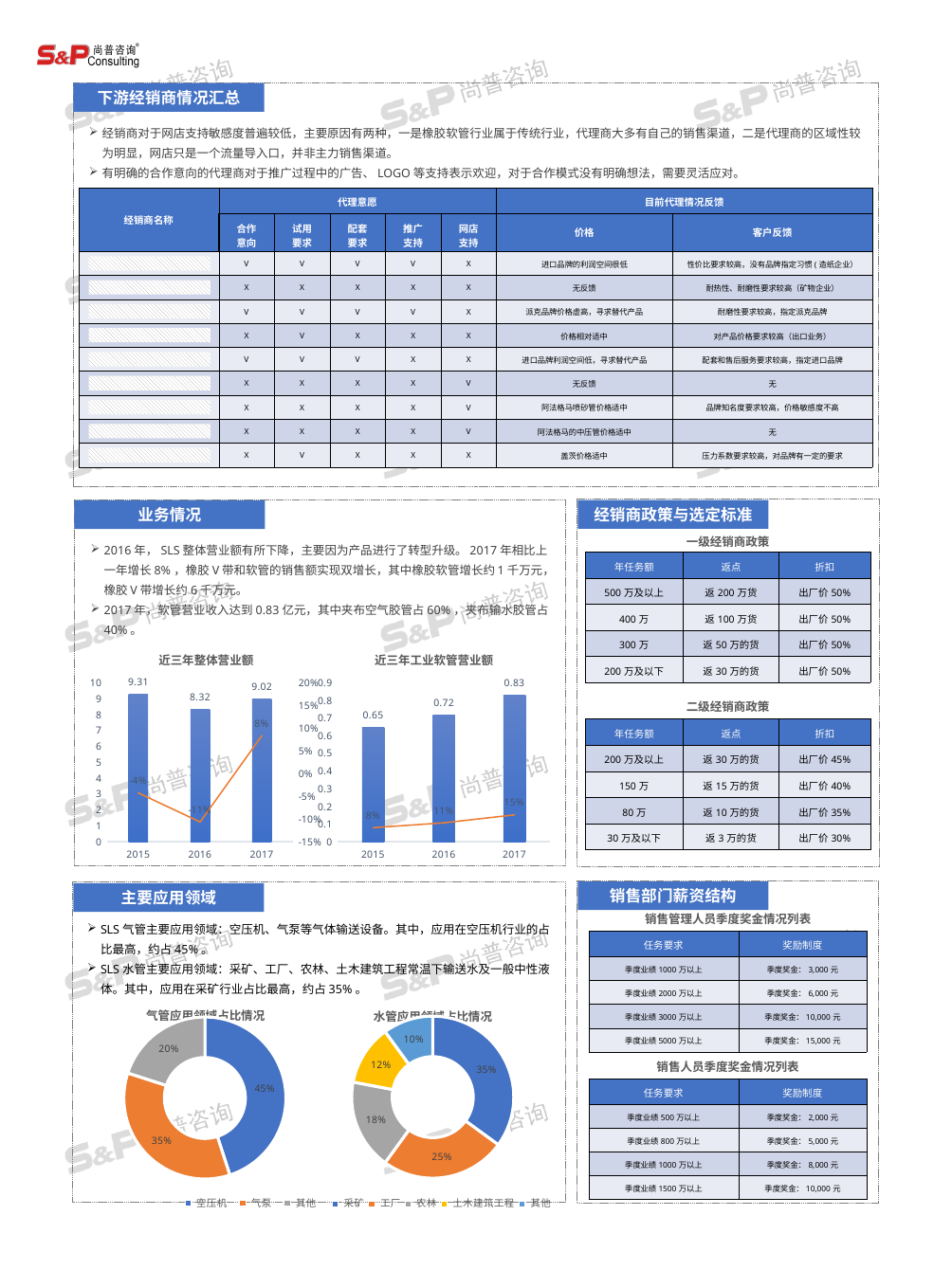
In the chart titled 近三年整体营业额, what is the difference between the 2015 and 2017 bar values? 0.29 In the chart titled 近三年工业软管营业额, what is the bar value for 2017? 0.83 In the chart titled 近三年整体营业额, what growth rate is labelled on the line for 2016? -11% In the chart titled 近三年工业软管营业额, how many years are shown on the x axis? 3 In the chart titled 近三年工业软管营业额, what is the difference between the 2017 and 2015 bar values? 0.18 In the chart titled 水管应用领域占比情况, how many slices are there? 5 In the chart titled 气管应用领域占比情况, what share does the largest slice have? 45% In the chart titled 近三年整体营业额, which year has the lowest bar value? 2016 What kind of chart is 气管应用领域占比情况? doughnut chart In the chart titled 近三年整体营业额, what is the bar value for 2015? 9.31 In the chart titled 水管应用领域占比情况, what is the smallest slice's share? 10% In the chart titled 近三年工业软管营业额, do the bar values rise or fall from 2015 to 2017? rise